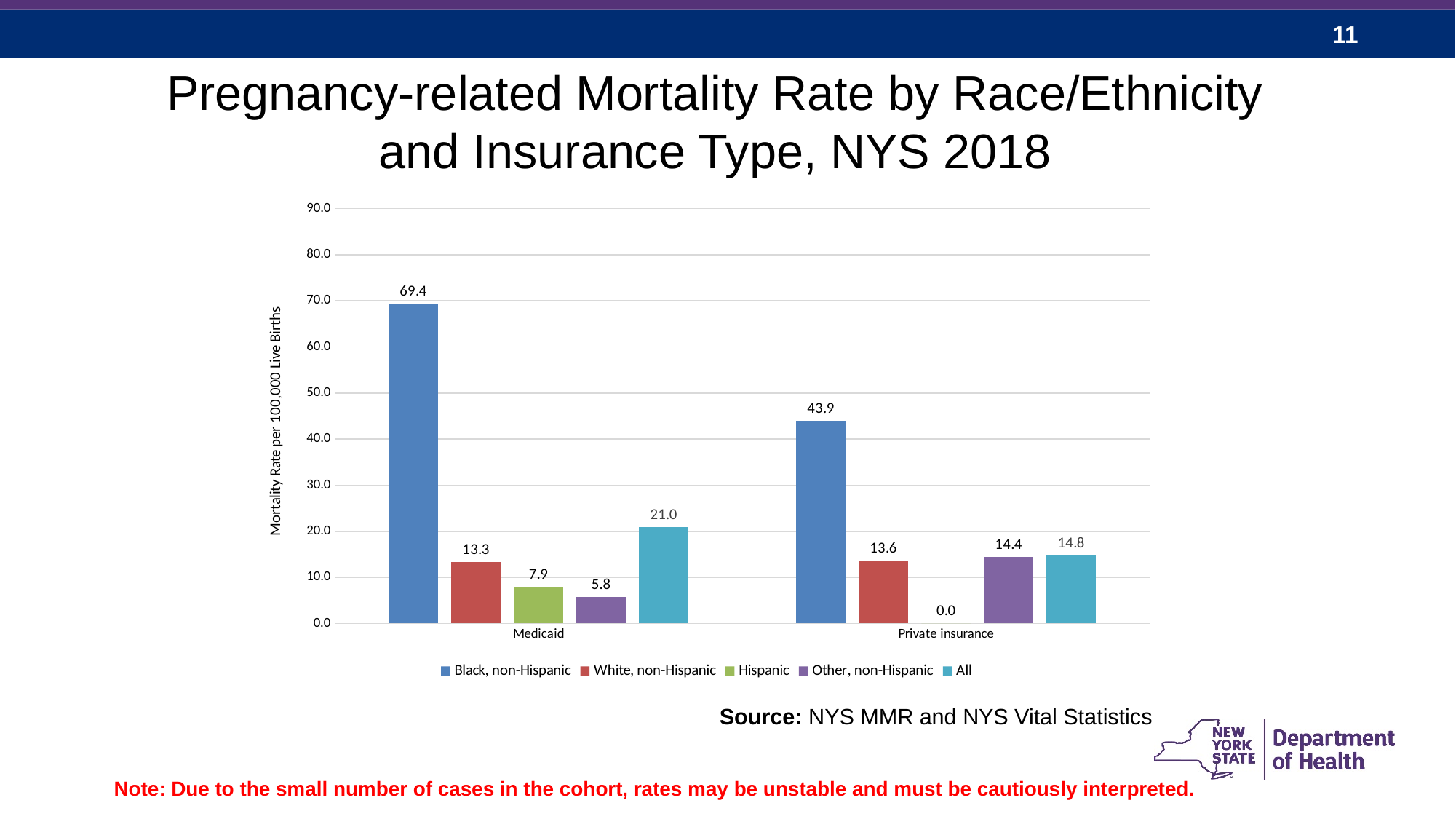
What kind of chart is shown on the slide? Bar chart What is the difference between the Black, non-Hispanic mortality rate for Medicaid and for Private insurance? 25.5 Which is larger: the White, non-Hispanic rate under Medicaid or under Private insurance? Private insurance How many insurance type categories are shown on the x axis? 2 What is the mortality rate for the All group under Private insurance? 14.8 What is the pregnancy-related mortality rate for Black, non-Hispanic women with Medicaid? 69.4 Which race/ethnicity group has the highest mortality rate under Medicaid? Black, non-Hispanic How many series does the legend list? 5 Which race/ethnicity group has the lowest mortality rate under Medicaid? Other, non-Hispanic What is the label of the vertical axis? Mortality Rate per 100,000 Live Births Is the value for the All group under Medicaid greater or less than 20.0? greater What is the mortality rate for Hispanic women under Private insurance? 0.0